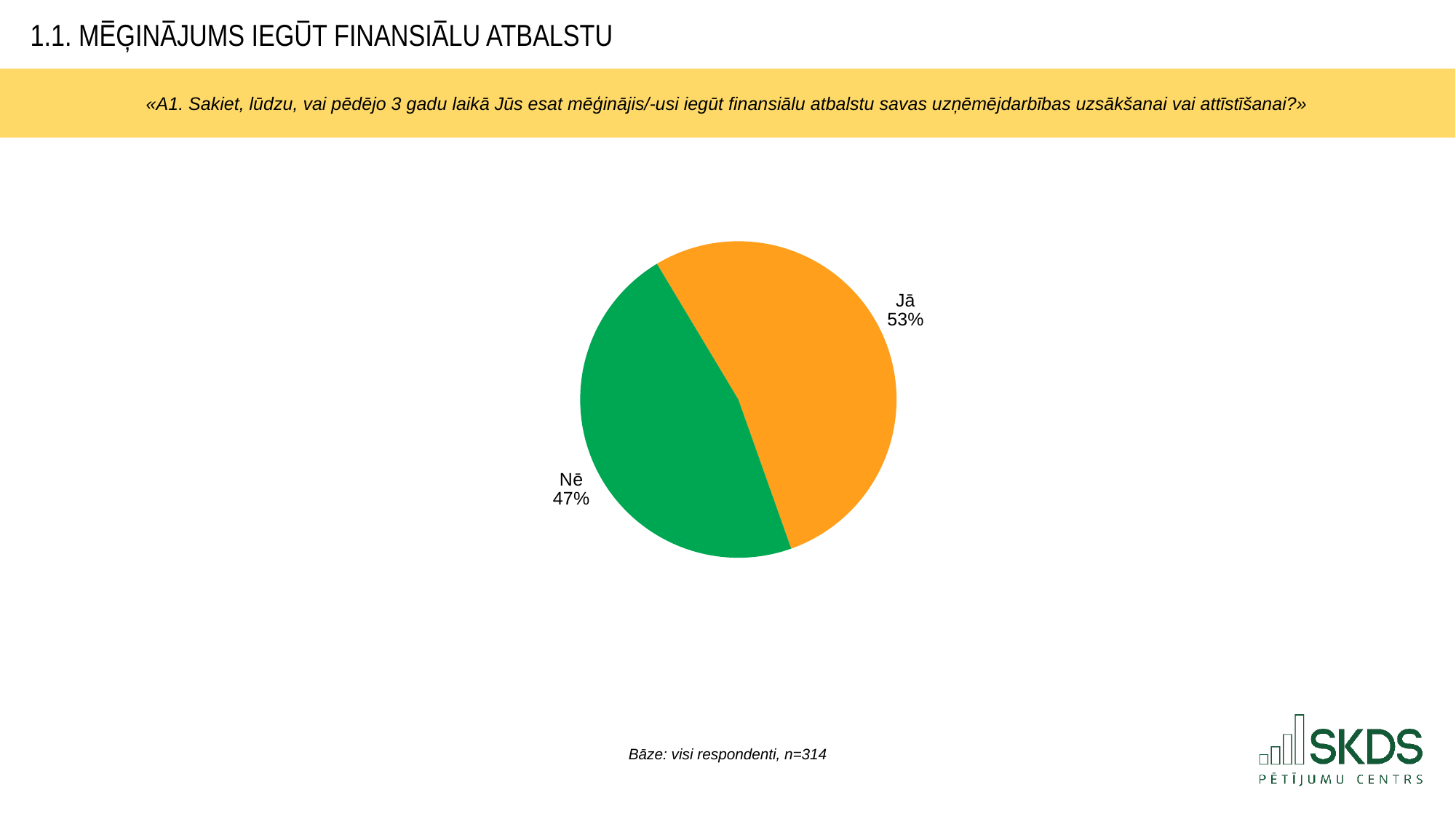
What colour is the "Jā" slice? orange What share of respondents answered "Nē"? 47% What colour is the "Nē" slice? green How many slices does the pie chart have? 2 What share of respondents answered "Jā"? 53% What is the total of the two slices shown in the pie chart? 100% Which slice of the pie is the largest? Jā What is the difference in percentage points between the "Jā" and "Nē" shares? 6 Which answer has the larger share, "Jā" or "Nē"? Jā Which slice of the pie is the smallest? Nē What kind of chart is shown on the slide? pie chart